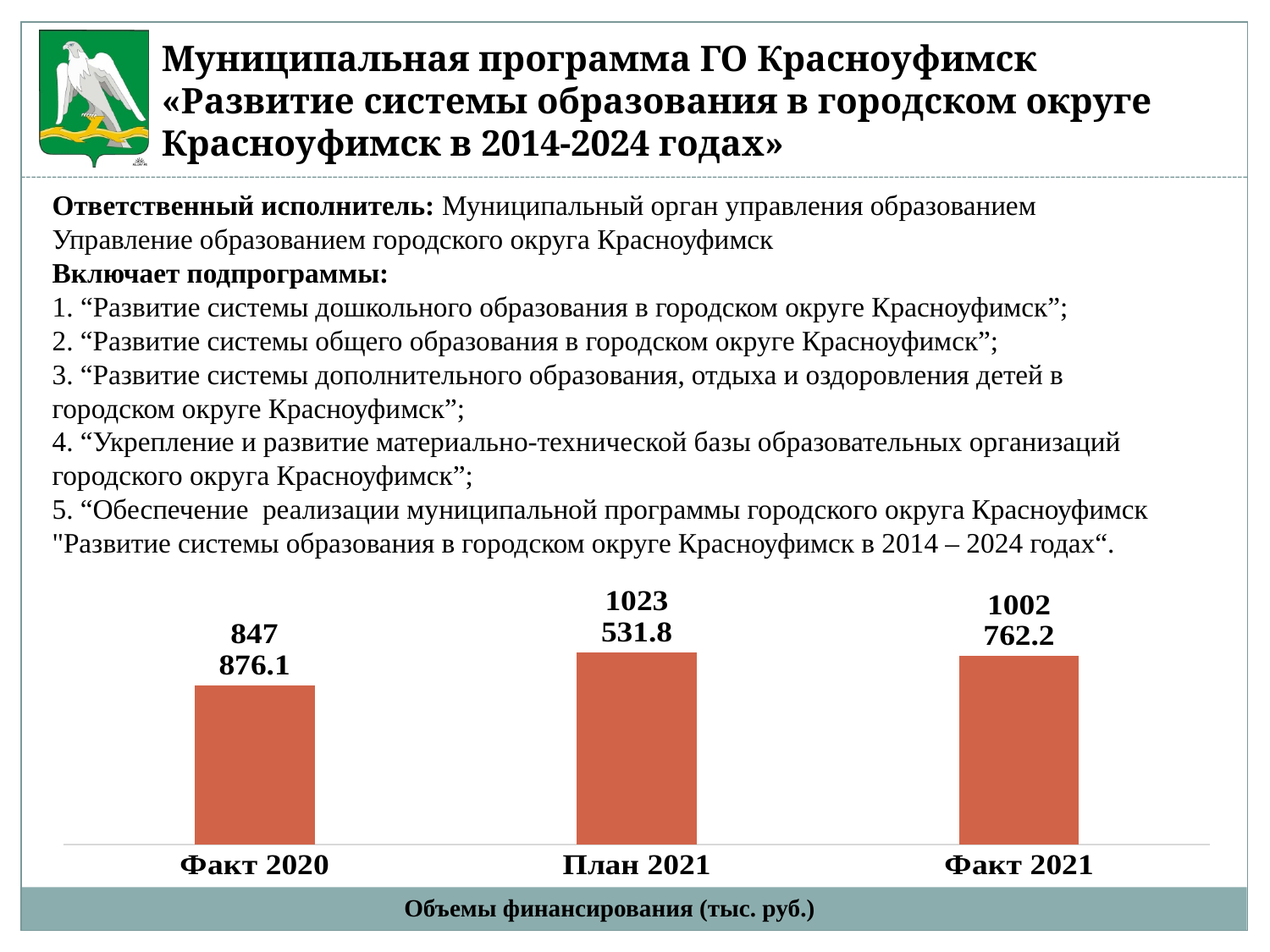
What is the difference between the values for План 2021 and Факт 2021? 20 769.6 What is the value for Факт 2020 in the chart 'Объемы финансирования (тыс. руб.)'? 847 876.1 What is the caption/title of the chart at the bottom of the slide? Объемы финансирования (тыс. руб.) Which category has the lowest value in the chart? Факт 2020 What is the value for План 2021 in the chart? 1023 531.8 How many categories are shown in the chart? 3 What is the value for Факт 2021 in the chart? 1002 762.2 What is the difference between the values for Факт 2021 and Факт 2020? 154 886.1 Which category has the highest value in the chart? План 2021 What kind of chart is shown on the slide? Bar chart Which is larger, the value for Факт 2020 or the value for Факт 2021? Факт 2021 What colour are the bars in the chart? Red-orange